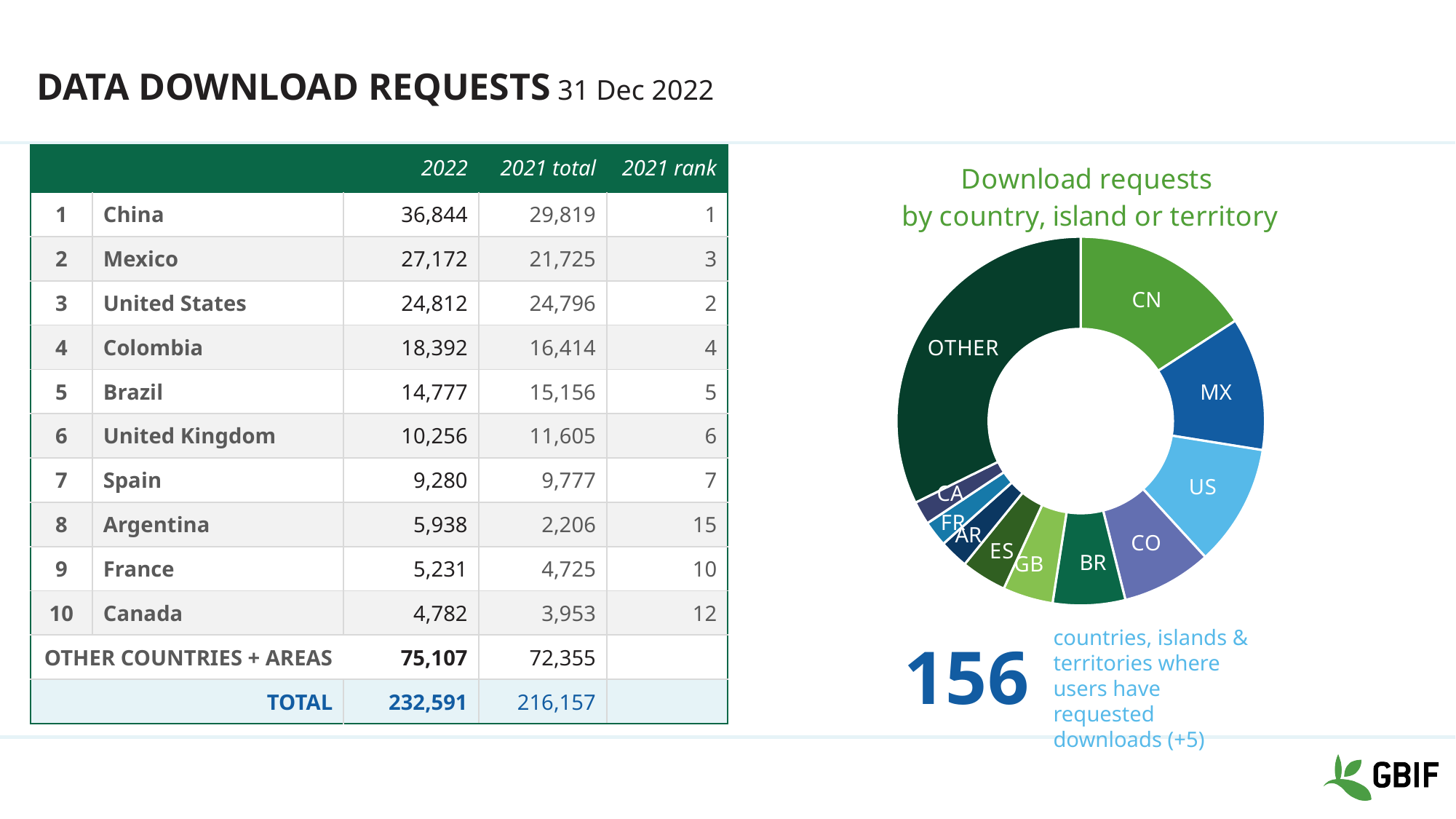
How many slices does the donut chart have? 11 According to the slide, how many 2022 download requests does the OTHER slice represent? 75,107 Which slice is larger in the donut chart, CO or BR? CO What is the difference in 2022 download requests between China and Mexico? 9,672 What is the title of the chart on the right? Download requests by country, island or territory Which labelled country slice is the smallest in the donut chart? CA Which slice of the donut chart is the largest? OTHER According to the slide, how many 2022 download requests does the CN slice represent? 36,844 Which slice is larger in the donut chart, MX or US? MX Which country slice (excluding OTHER) is the largest in the donut chart? CN What is the total number of 2022 download requests represented by the whole donut chart? 232,591 What kind of chart is shown on the right of the slide? Donut (pie) chart